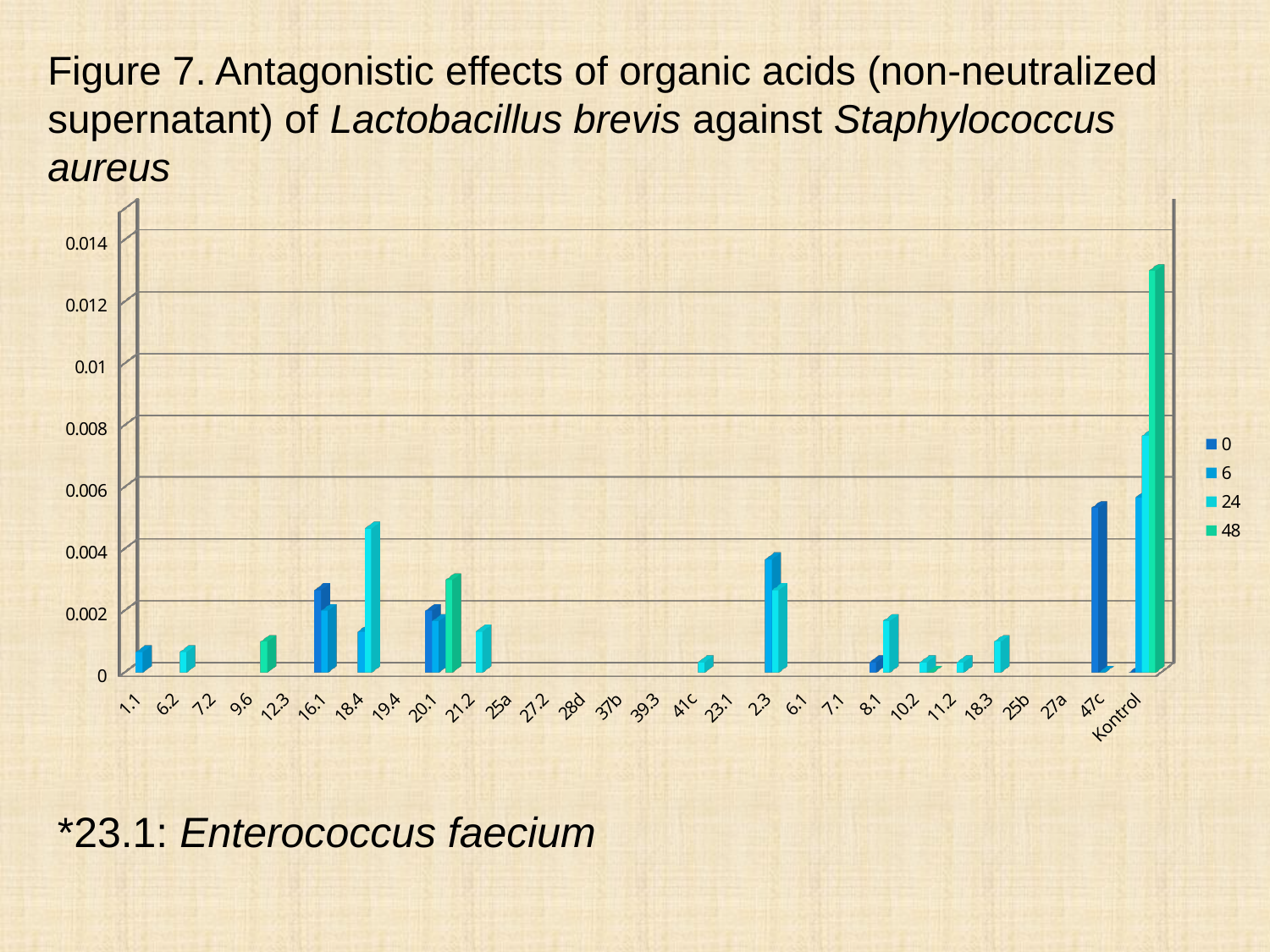
How many categories are shown along the x axis? 28 What is the label of the last category on the x axis? Kontrol What kind of chart is shown on the slide? Bar chart What are the series names listed in the legend? 0, 6, 24, 48 Is the value for 16.1 in the 0 series greater or less than 0.004? less Is the value for Kontrol in the 48 series greater or less than 0.012? greater Is the value for 47c in the 0 series greater or less than 0.004? greater Which category has the highest value for the 48 series? Kontrol How many series does the legend list? 4 Which is larger: the value for Kontrol in the 48 series or the value for 47c in the 0 series? Kontrol in the 48 series